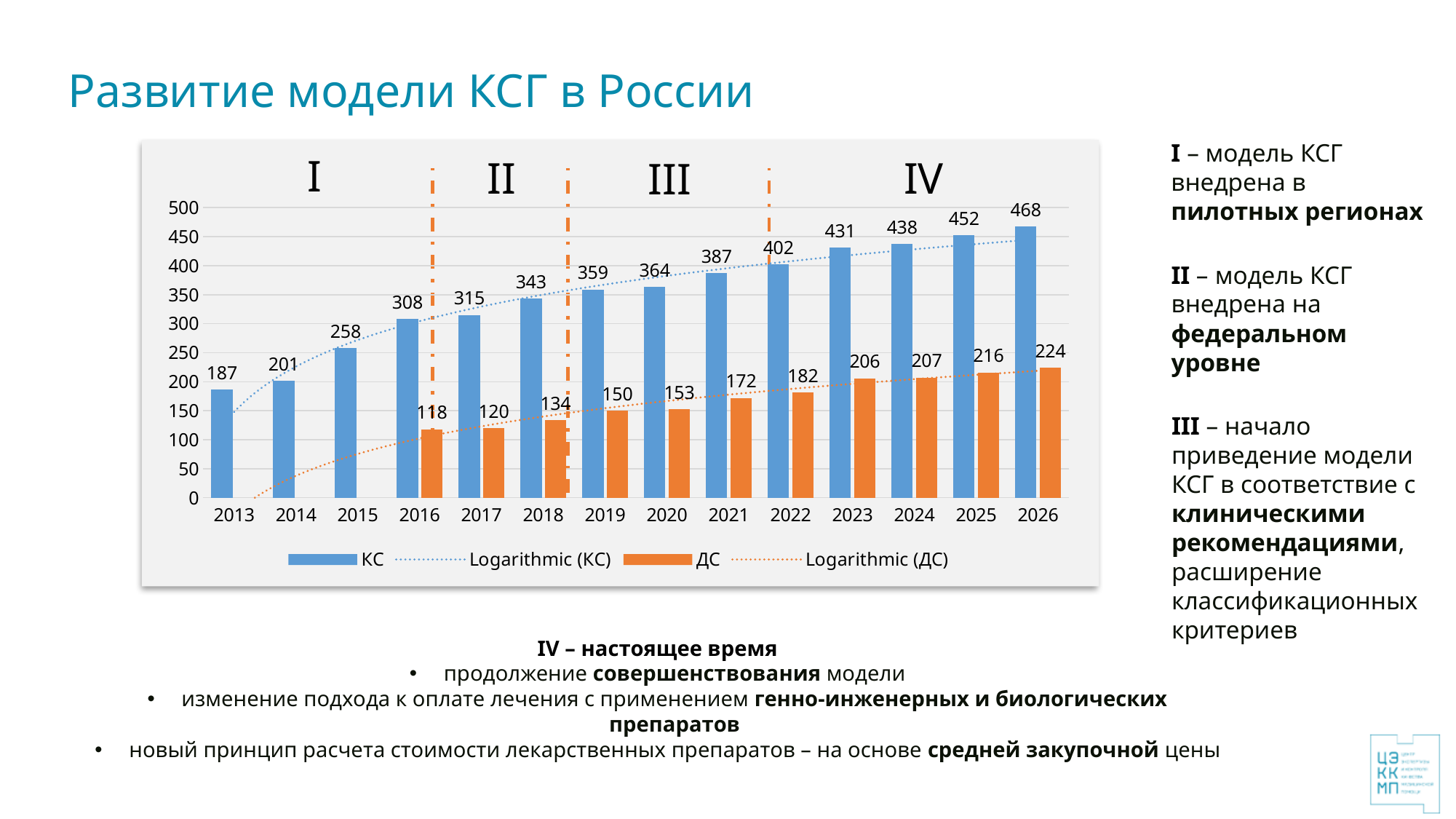
What colour are the ДС bars in the chart? Orange What type of chart is shown on the slide? Bar chart What is the value of КС in 2019? 359 What is the value of ДС in 2023? 206 How many entries does the chart legend list? 4 Which is larger in 2021: the КС value or the ДС value? КС How many years are shown on the x axis of the chart? 14 In which year is the ДС value lowest? 2016 What is the value of КС in 2013? 187 What is the difference between the КС and ДС values in 2026? 244 In which year is the КС value highest? 2026 Do the КС values rise or fall from 2013 to 2026? Rise